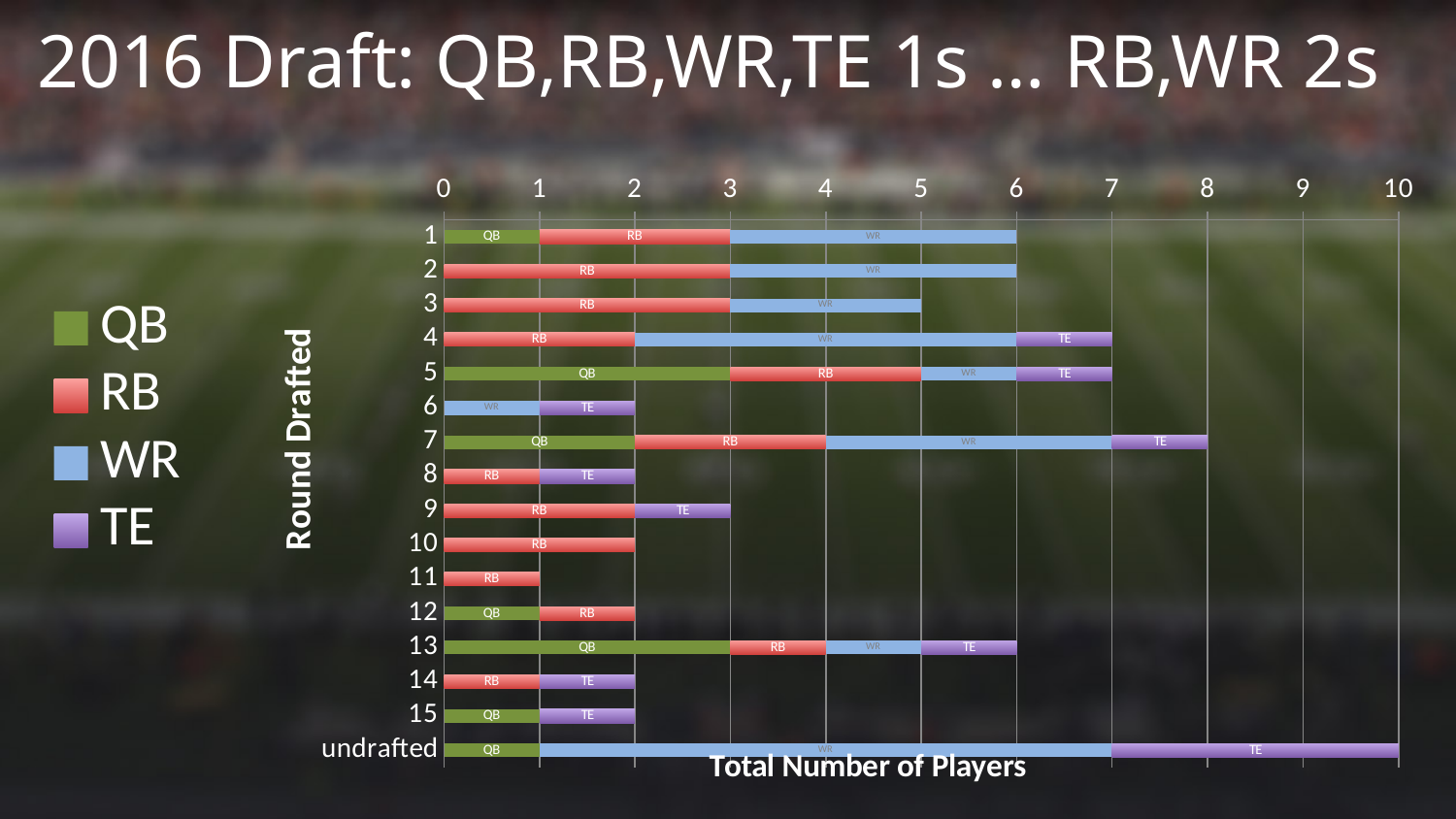
Which category has the highest total number of players? undrafted How many series does the legend list? 4 What is the title of the horizontal axis? Total Number of Players How many RB players were drafted in round 2? 3 Is the total number of players for round 13 greater or less than 5? greater Which has a larger total number of players, round 4 or round 6? Round 4 What kind of chart is shown on the slide? Stacked bar chart What is the total number of players for the undrafted category? 10 How many WR players are in the undrafted category? 6 What is the total number of players for round 7? 8 Which round has the lowest total number of players? 11 How many categories are shown on the Round Drafted axis? 16